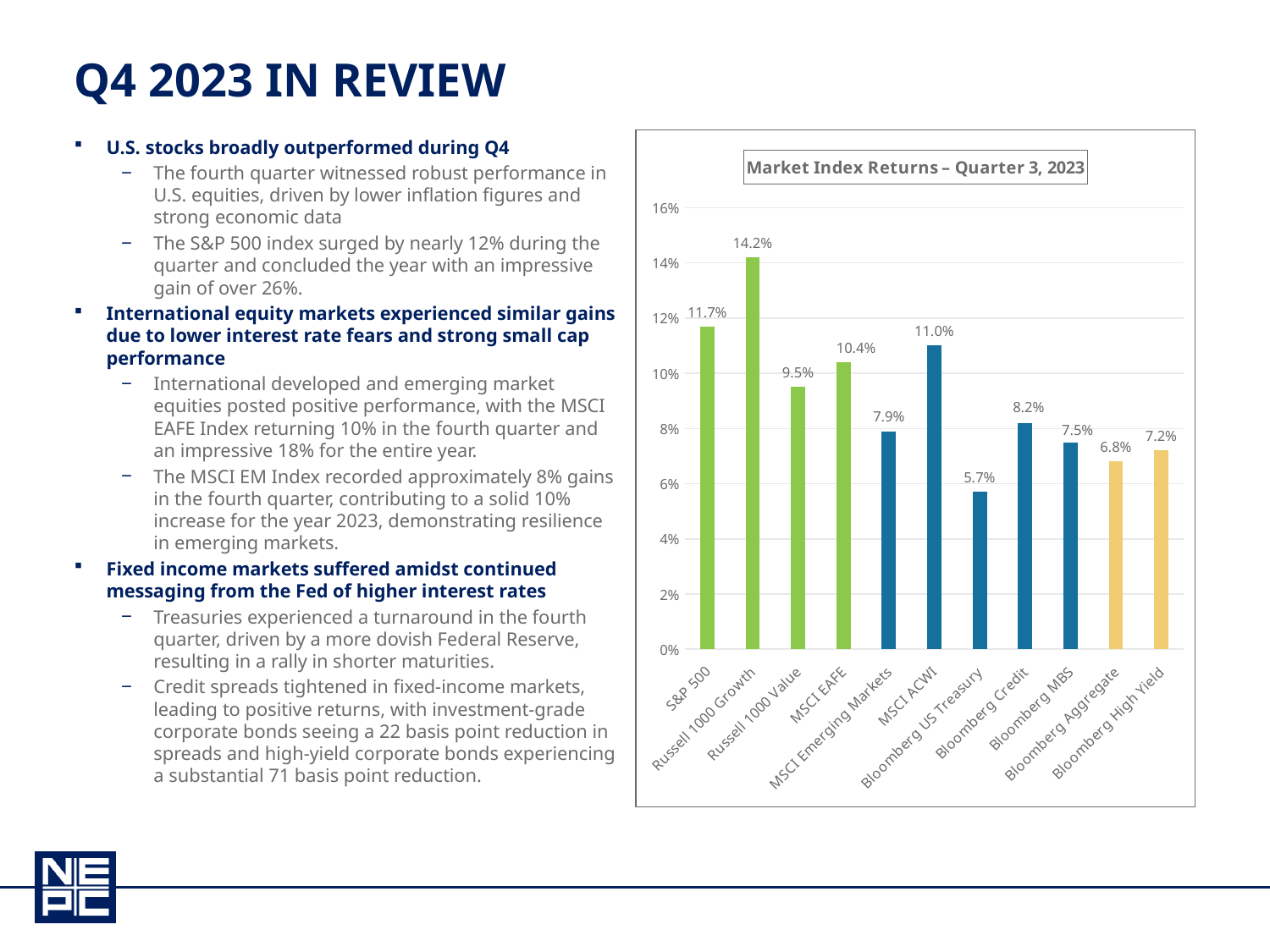
What kind of chart is the Market Index Returns chart? Bar chart Which has a higher return in the Market Index Returns chart, Bloomberg Credit or Bloomberg MBS? Bloomberg Credit What is the difference between the S&P 500 and Russell 1000 Value returns in the Market Index Returns chart? 2.2% Which index has the lowest return in the Market Index Returns chart? Bloomberg US Treasury What is the value for Bloomberg US Treasury in the Market Index Returns chart? 5.7% Which index has the highest return in the Market Index Returns chart? Russell 1000 Growth What is the difference between the Bloomberg High Yield and Bloomberg Aggregate returns in the Market Index Returns chart? 0.4% What is the value for MSCI EAFE in the Market Index Returns chart? 10.4% Is the value for MSCI ACWI in the Market Index Returns chart greater or less than 10%? greater What is the value for Russell 1000 Growth in the Market Index Returns chart? 14.2% What is the title of the chart on the slide? Market Index Returns – Quarter 3, 2023 How many indices are shown in the Market Index Returns chart? 11